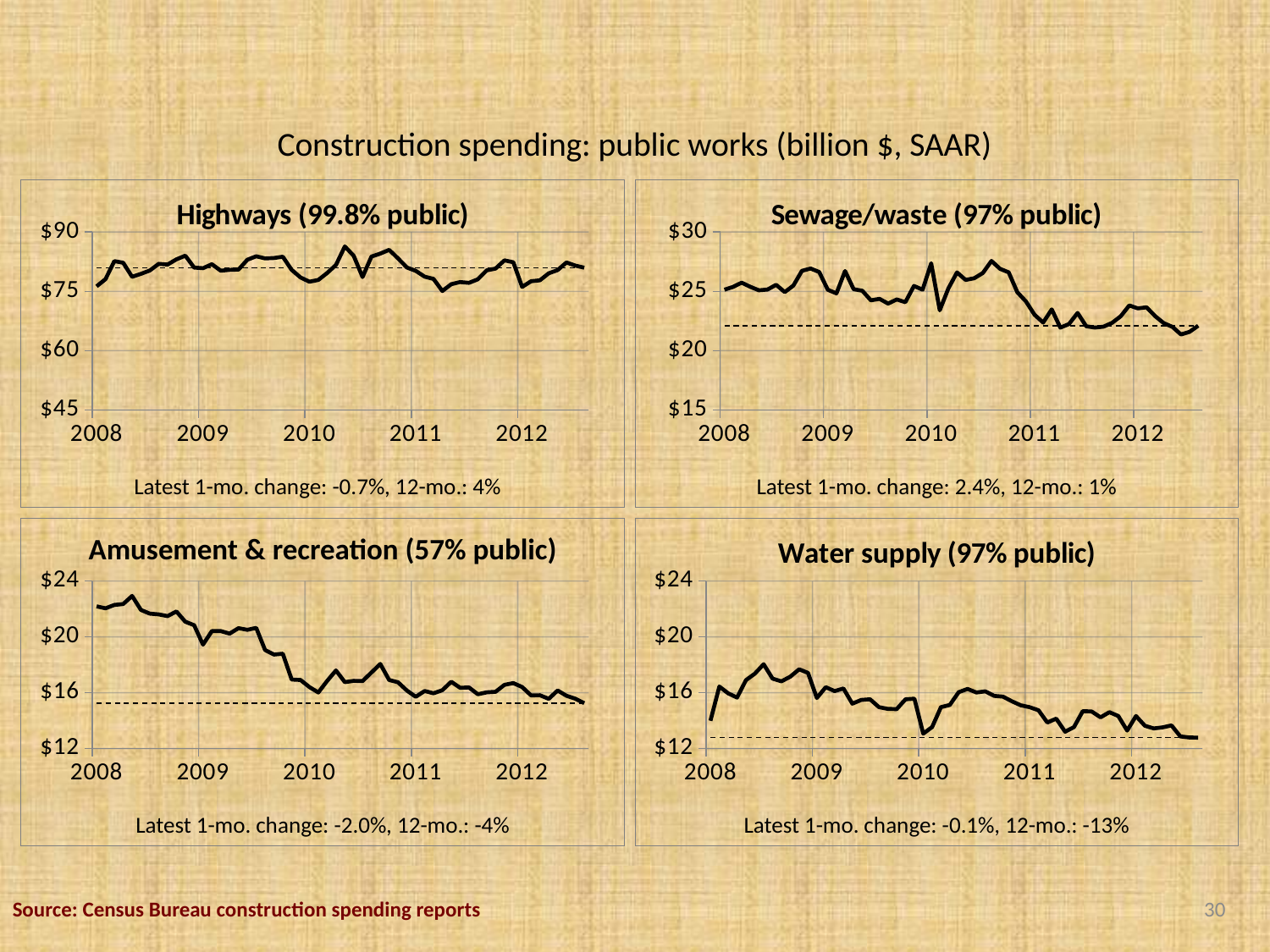
In the Highways (99.8% public) chart, is the value at the start of 2008 greater or less than $60? greater In the Sewage/waste (97% public) chart, do the values rise or fall overall from 2008 to 2012? fall What kind of chart is the Highways (99.8% public) chart? line chart In the Amusement & recreation (57% public) chart, is the value at the end of 2012 greater or less than $16? less In the Sewage/waste (97% public) chart, is the value at the end of 2012 greater or less than $25? less What is the overall title of the slide above the charts? Construction spending: public works (billion $, SAAR) How many charts are shown on the slide? 4 In the Water supply (97% public) chart, do the values rise or fall from 2008 to 2012? fall In the Amusement & recreation (57% public) chart, do the values rise or fall from 2008 to 2012? fall